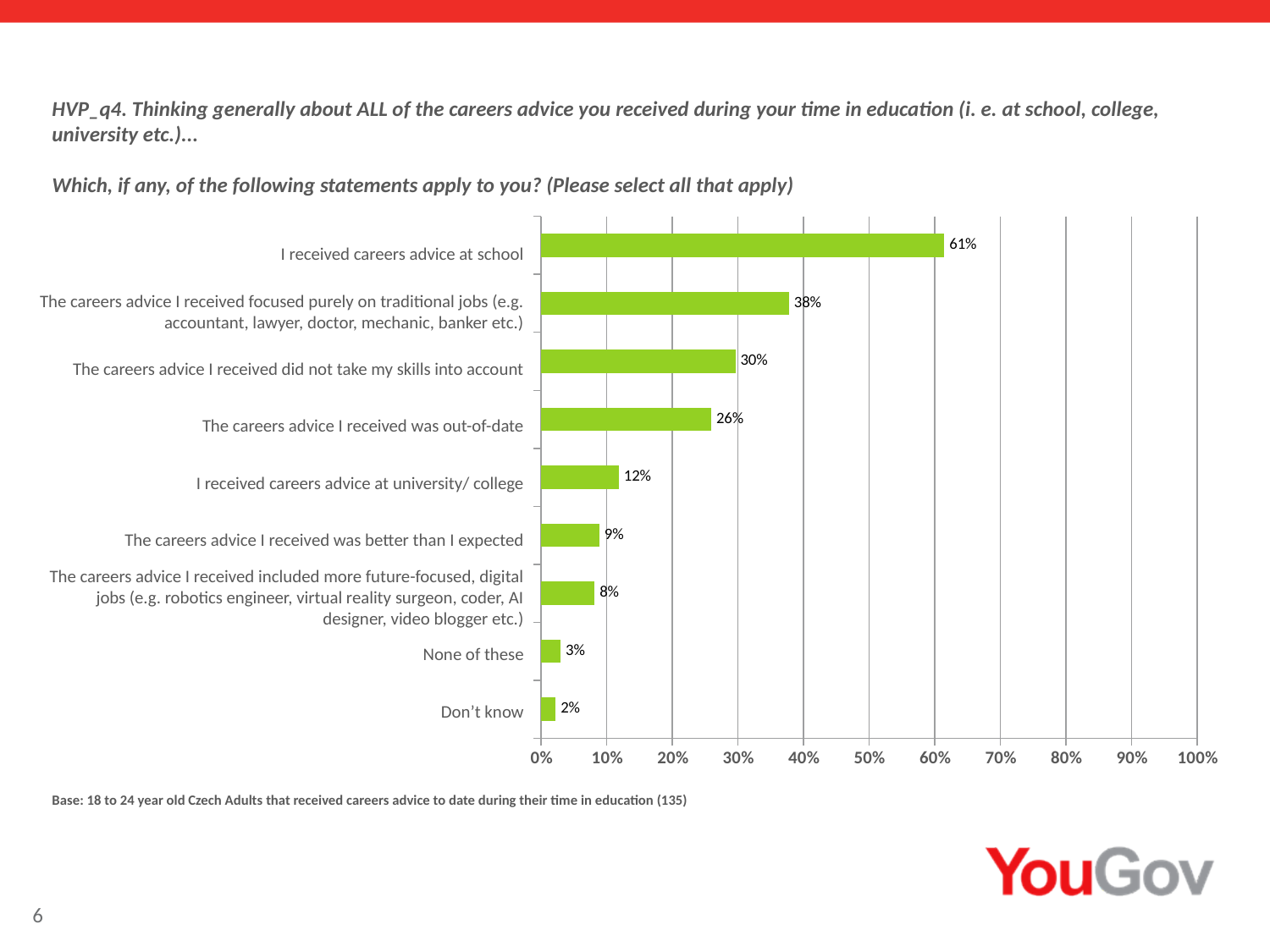
Which category has the lowest percentage? Don't know What percentage said the careers advice they received was out-of-date? 26% What percentage said they received careers advice at university/ college? 12% Is the value for 'The careers advice I received focused purely on traditional jobs' greater or less than 40%? less What type of chart is shown on the slide? Bar chart What percentage of respondents said they received careers advice at school? 61% What is the base size stated below the chart? 135 How many statements (categories) are shown in the chart? 9 Which is larger: the percentage for 'The careers advice I received did not take my skills into account' or for 'The careers advice I received was out-of-date'? The careers advice I received did not take my skills into account What is the difference in percentage points between 'I received careers advice at school' and 'I received careers advice at university/ college'? 49 What percentage answered 'Don't know'? 2% Which statement has the highest percentage? I received careers advice at school